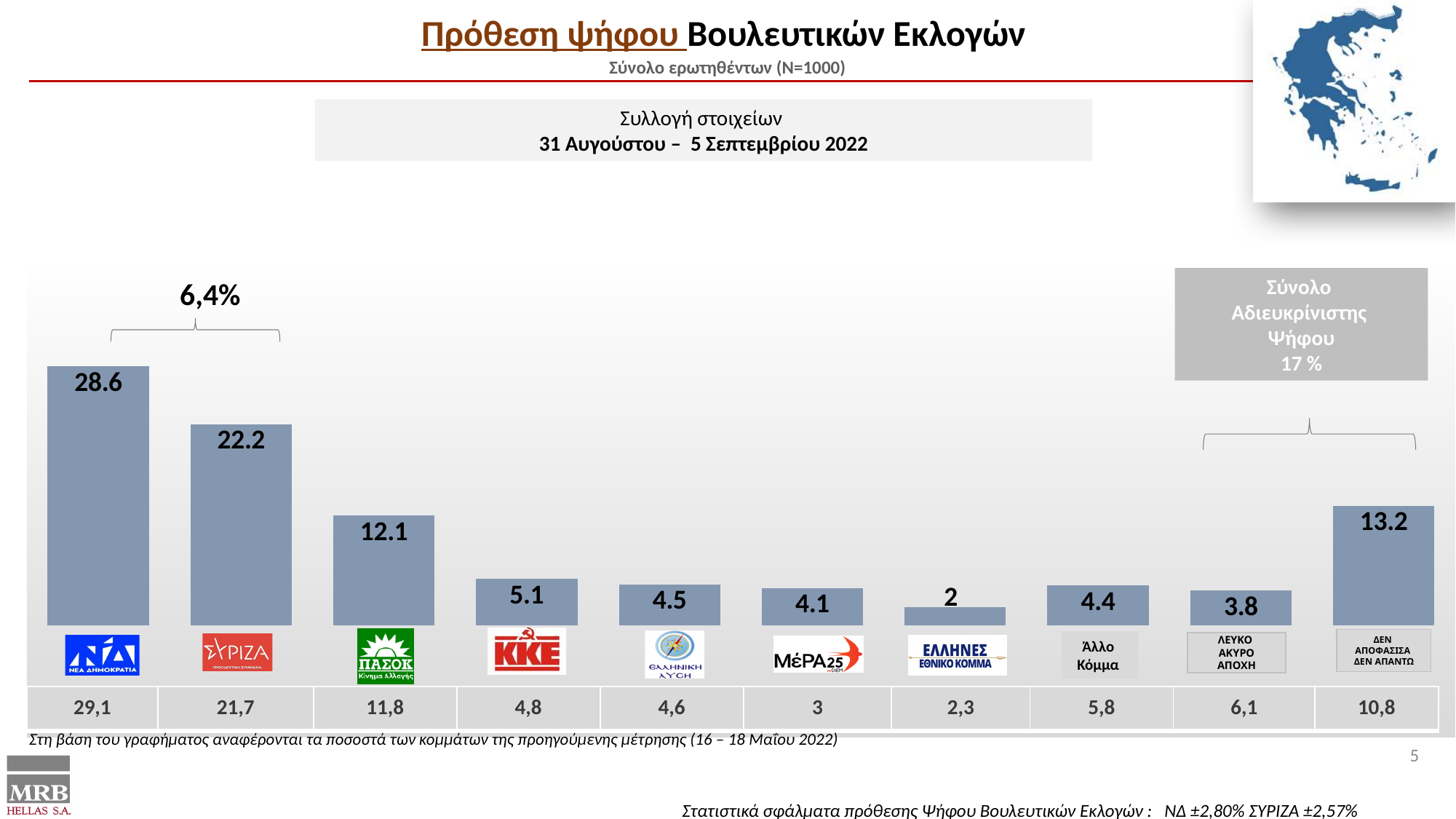
What kind of chart is shown on the slide? Bar chart What is the value shown for ΣΥΡΙΖΑ in the vote intention chart? 22.2 What is the difference between the values for ΝΕΑ ΔΗΜΟΚΡΑΤΙΑ and ΣΥΡΙΖΑ in the vote intention chart? 6.4 What is the value shown for ΚΚΕ in the vote intention chart? 5.1 Which category has the highest value in the vote intention chart? ΝΕΑ ΔΗΜΟΚΡΑΤΙΑ What is the value shown for ΠΑΣΟΚ in the vote intention chart? 12.1 What was the value for ΝΕΑ ΔΗΜΟΚΡΑΤΙΑ in the previous measurement shown in the row below the chart? 29,1 Which has a larger value in the vote intention chart, ΚΚΕ or ΕΛΛΗΝΙΚΗ ΛΥΣΗ? ΚΚΕ What is the value shown for ΝΕΑ ΔΗΜΟΚΡΑΤΙΑ in the vote intention chart? 28.6 What is the value shown for the ΔΕΝ ΑΠΟΦΑΣΙΣΑ ΔΕΝ ΑΠΑΝΤΩ bar? 13.2 Which category has the lowest value in the vote intention chart? ΕΛΛΗΝΕΣ ΕΘΝΙΚΟ ΚΟΜΜΑ How many bars are plotted in the vote intention chart? 10